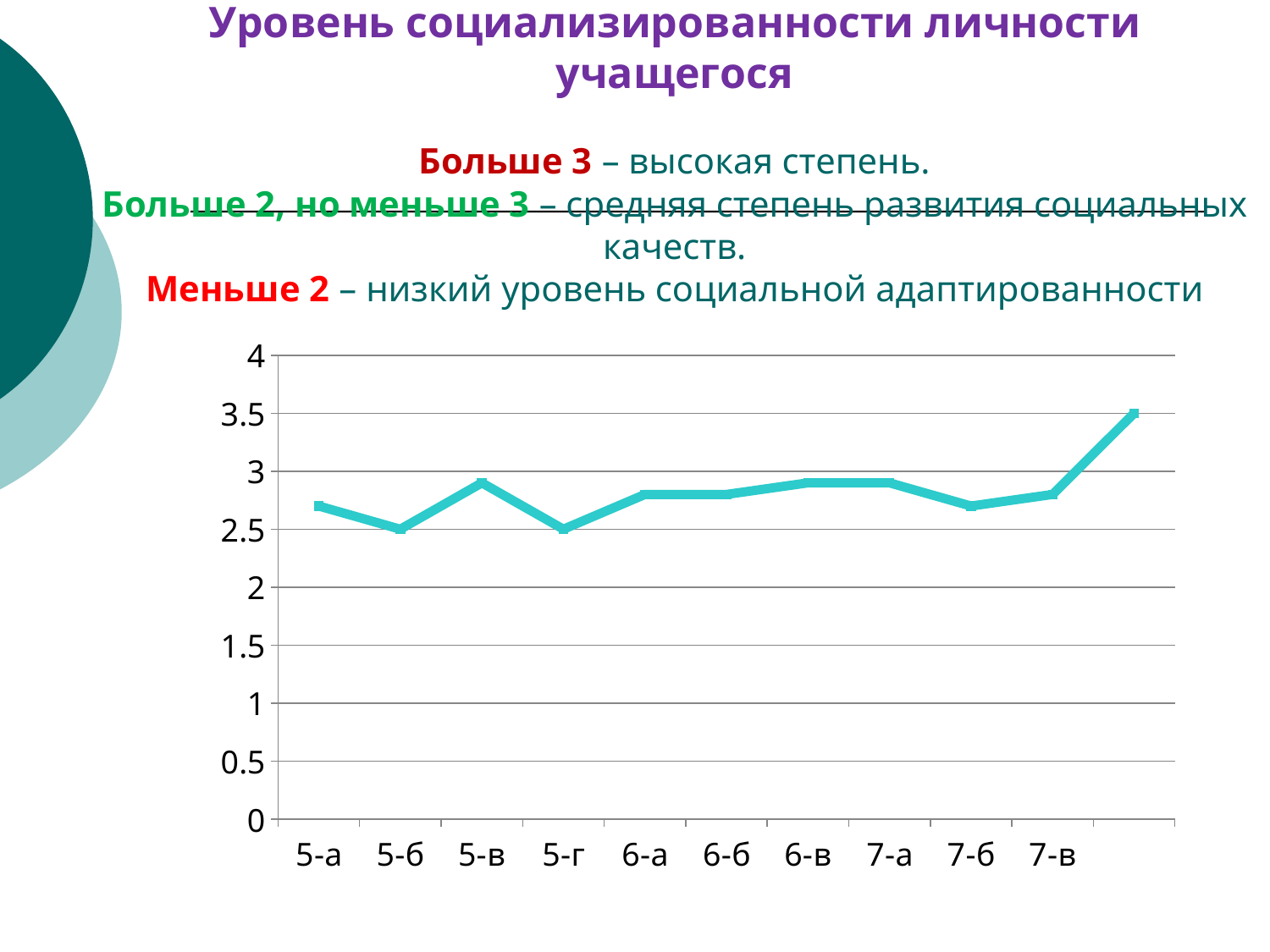
Does the line rise or fall from 5-б to 5-в? rise What kind of chart is shown on the slide? line chart What is the value for 5-г? 2.5 Is the value for 6-в greater or less than 3? less Which has the larger value, 5-в or 5-г? 5-в Which has the larger value, 5-а or 5-б? 5-а What colour is the line in the chart? turquoise What is the value for 5-б? 2.5 Is the value for 7-б greater or less than 2? greater Does the line rise or fall from 5-а to 5-б? fall Is the value for 5-в greater or less than 2.5? greater